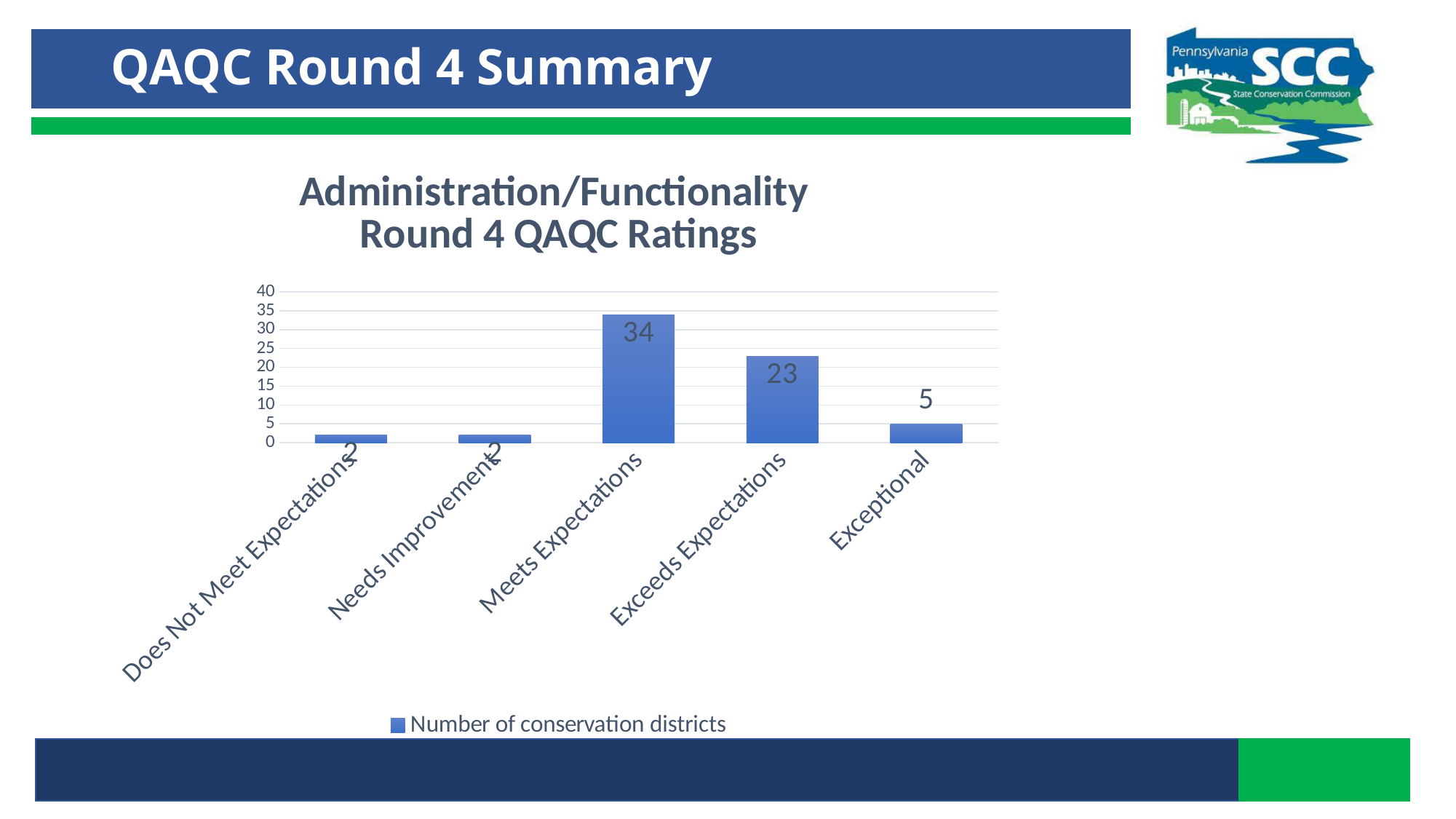
What is the difference between the Meets Expectations and Exceeds Expectations values? 11 What series name appears in the legend? Number of conservation districts Which rating category has the highest number of conservation districts? Meets Expectations What is the title of the chart? Administration/Functionality Round 4 QAQC Ratings What is the number of conservation districts rated Exceptional? 5 What is the number of conservation districts rated Exceeds Expectations? 23 Which is larger, the value for Exceeds Expectations or the value for Exceptional? Exceeds Expectations How many rating categories are shown on the x axis? 5 Is the value for Needs Improvement greater or less than 5? less What is the number of conservation districts rated Meets Expectations? 34 What type of chart is shown on the slide? bar chart How many series does the legend list? 1